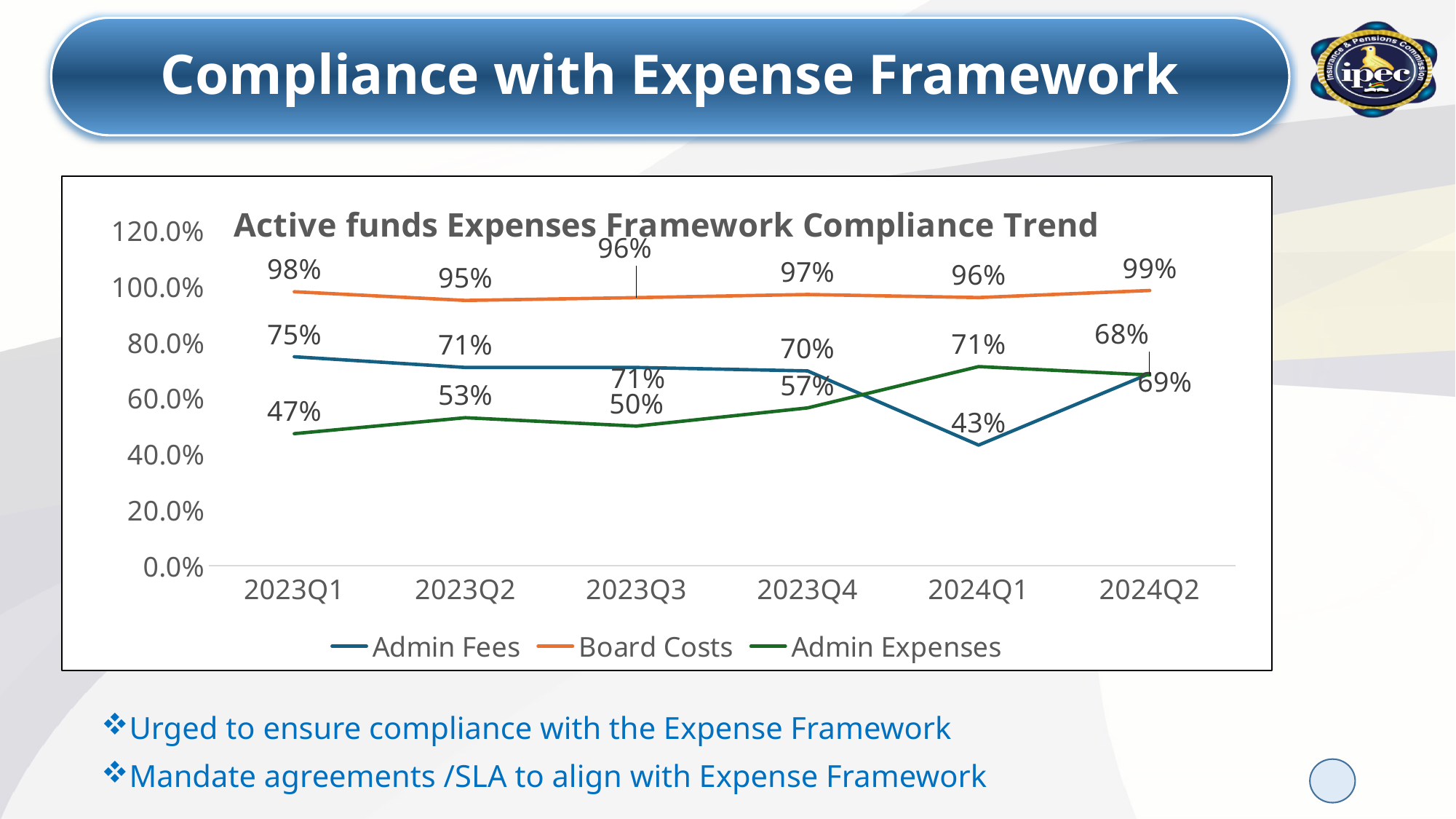
How many quarters are plotted along the x axis? 6 What is the Admin Fees value for 2024Q1? 43% In which quarter is Admin Fees compliance lowest? 2024Q1 What is the Board Costs compliance value for 2023Q1? 98% In which quarter is Board Costs compliance highest? 2024Q2 What is the Admin Expenses value for 2023Q1? 47% What is the title of the chart? Active funds Expenses Framework Compliance Trend What kind of chart is shown on the slide? line chart How many series does the legend list? 3 What is the difference between the Board Costs value in 2024Q2 and in 2023Q2? 4 percentage points In 2023Q4, which is larger: Admin Fees or Admin Expenses? Admin Fees Is the Admin Expenses value for 2023Q2 greater or less than 60.0%? less